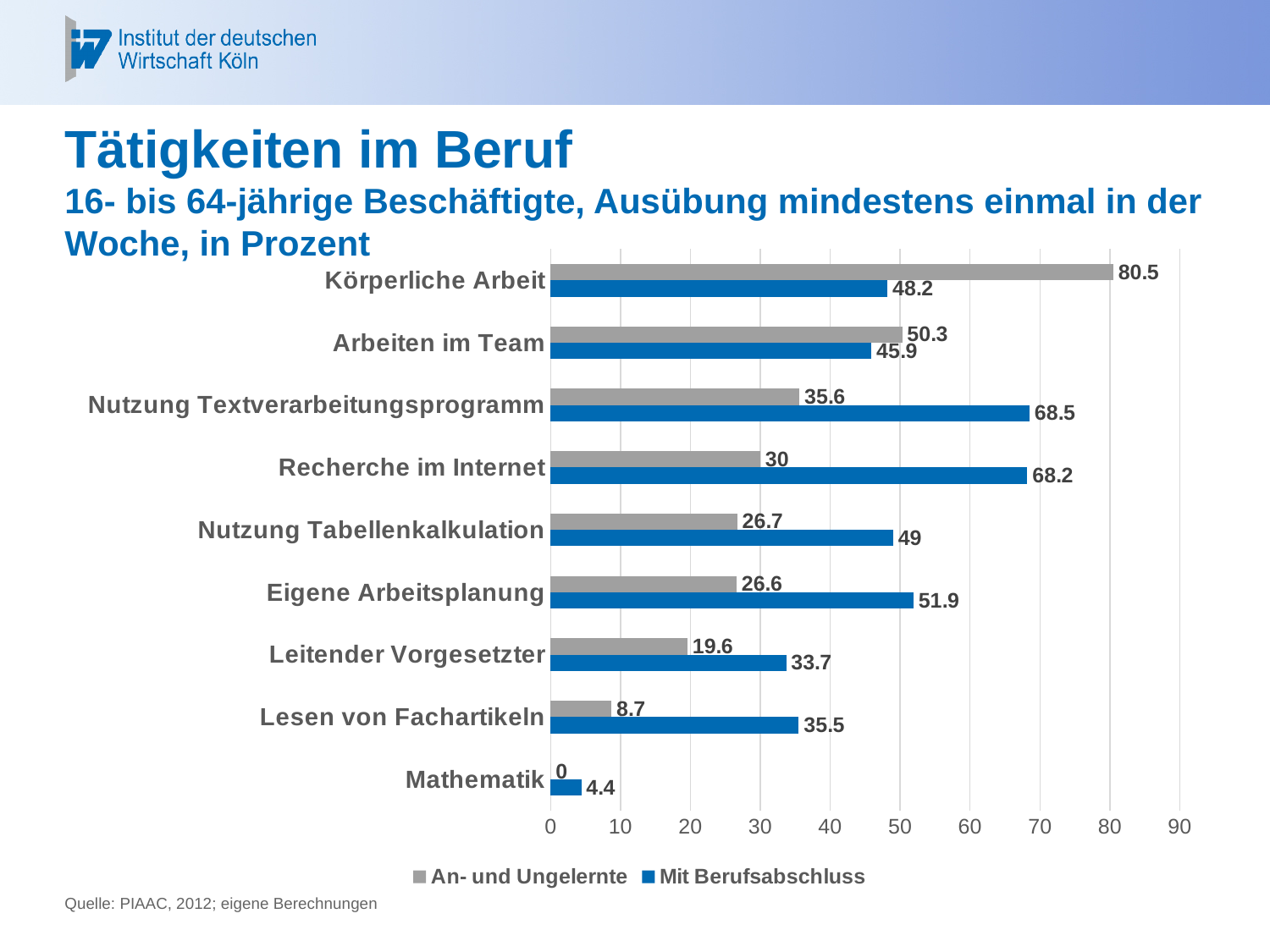
What is the value for 'Mit Berufsabschluss' for Mathematik? 4.4 How many series does the legend list? 2 What kind of chart is shown on the slide? Bar chart Which category has the lowest value for 'An- und Ungelernte'? Mathematik What is the value for 'An- und Ungelernte' for Körperliche Arbeit? 80.5 Is the 'Mit Berufsabschluss' value for Eigene Arbeitsplanung greater or less than 50? greater What is the value for 'Mit Berufsabschluss' for Recherche im Internet? 68.2 What is the difference between the 'Mit Berufsabschluss' and 'An- und Ungelernte' values for Nutzung Tabellenkalkulation? 22.3 What is the source cited below the chart? PIAAC, 2012; eigene Berechnungen How many categories are shown on the chart? 9 For Arbeiten im Team, which series has the larger value: 'An- und Ungelernte' or 'Mit Berufsabschluss'? An- und Ungelernte Which category has the highest value for 'Mit Berufsabschluss'? Nutzung Textverarbeitungsprogramm